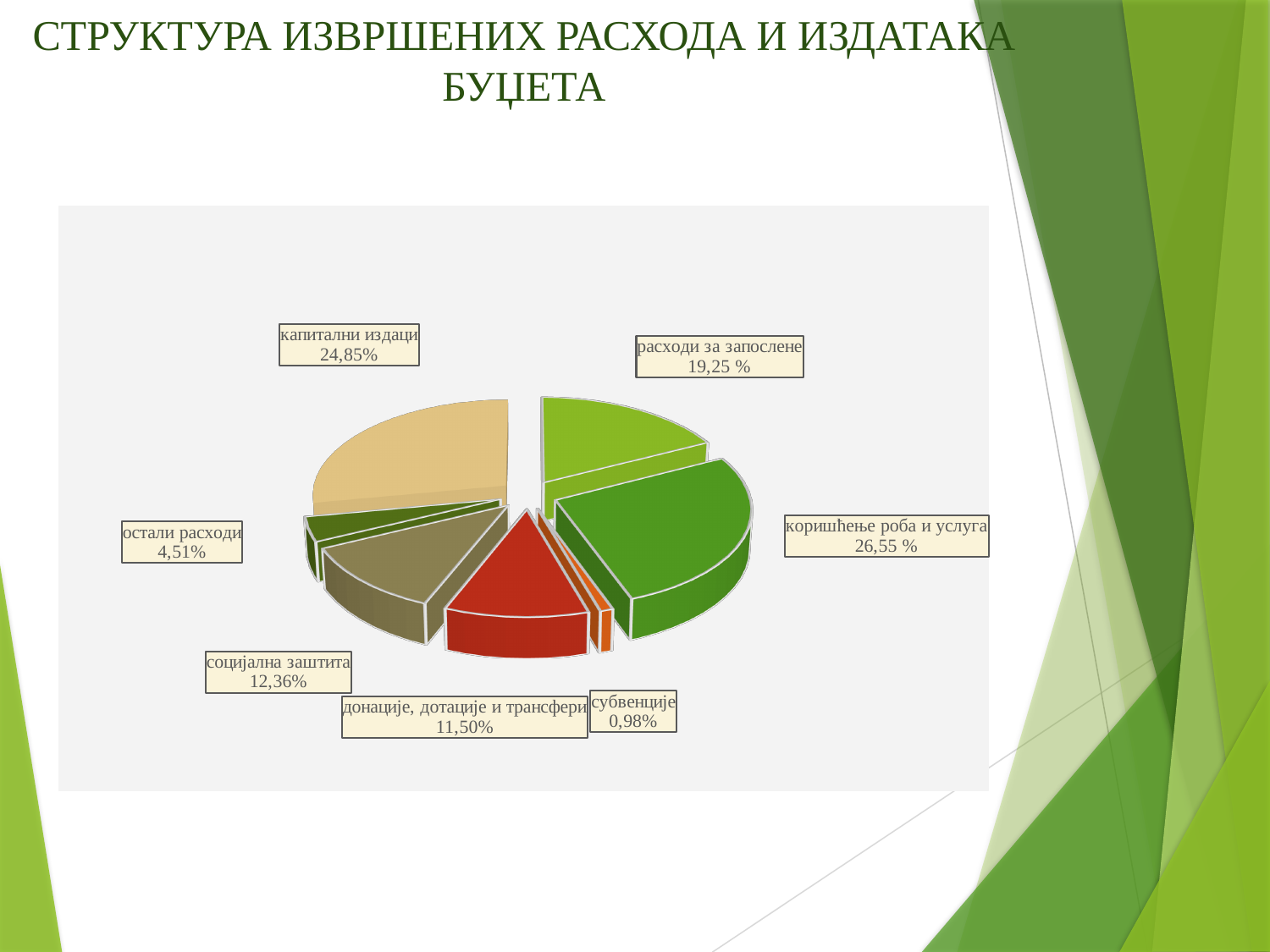
Which is larger, капитални издаци or расходи за запослене? капитални издаци How many categories are shown in the pie chart? 7 What type of chart is shown on the slide? pie chart What is the value for донације, дотације и трансфери? 11,50% What share of the pie does капитални издаци represent? 24,85% Which category has the smallest slice of the pie? субвенције What is the difference between социјална заштита and донације, дотације и трансфери? 0,86% What is the difference between коришћење роба и услуга and капитални издаци? 1,70 % Which is larger, социјална заштита or остали расходи? социјална заштита What percentage is labelled for субвенције? 0,98% What is the value shown for коришћење роба и услуга? 26,55 %